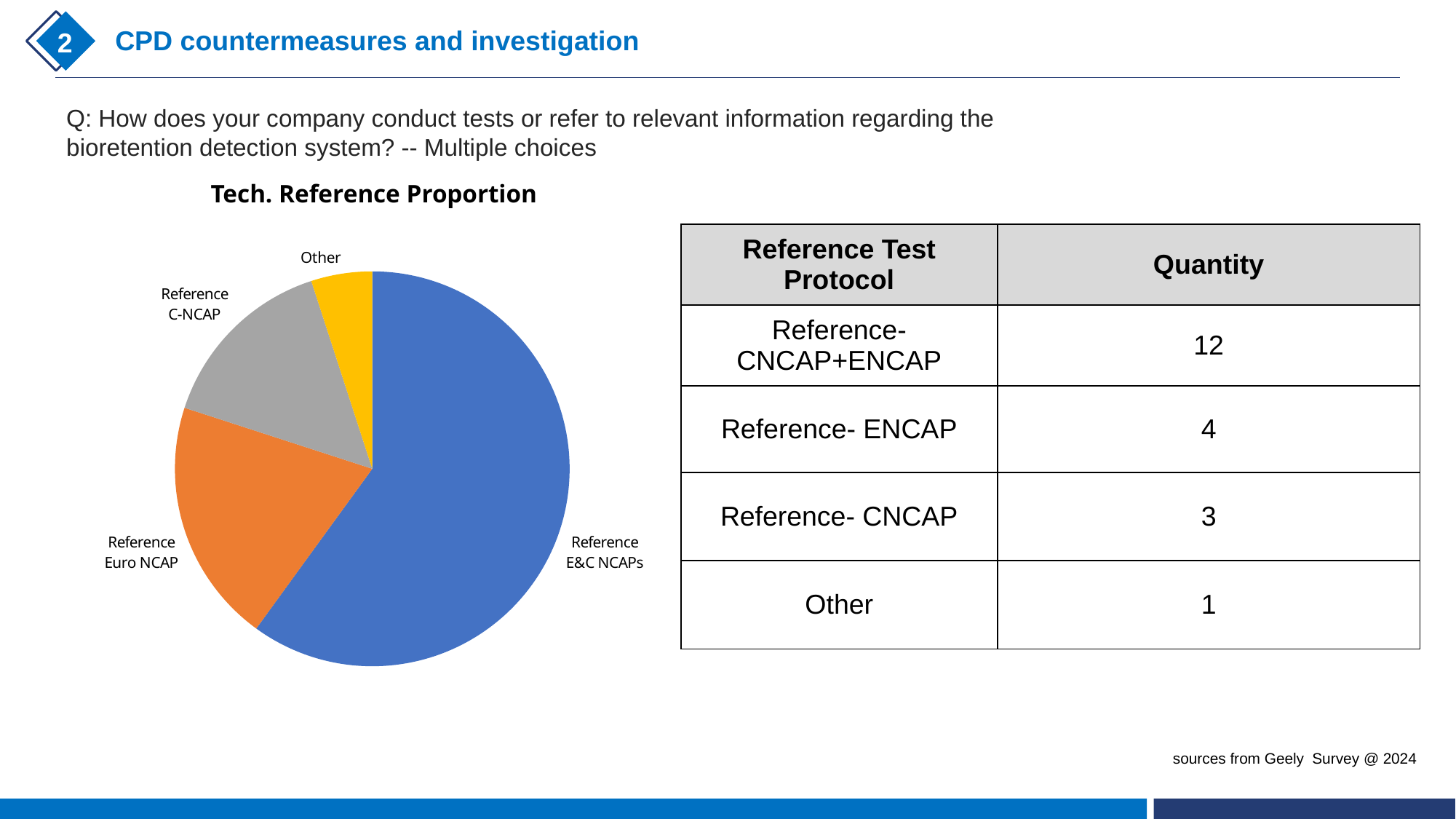
Which slice is larger in the pie chart, Reference Euro NCAP or Reference C-NCAP? Reference Euro NCAP Which category has the largest slice in the pie chart? Reference E&C NCAPs Which category has the smallest slice in the pie chart? Other Which slice is larger in the pie chart, Reference E&C NCAPs or Reference Euro NCAP? Reference E&C NCAPs Which slice is larger in the pie chart, Reference C-NCAP or Other? Reference C-NCAP How many slices does the pie chart have? 4 What colour is the Reference E&C NCAPs slice in the pie chart? blue What kind of chart is shown on the slide? pie chart What is the title of the pie chart? Tech. Reference Proportion